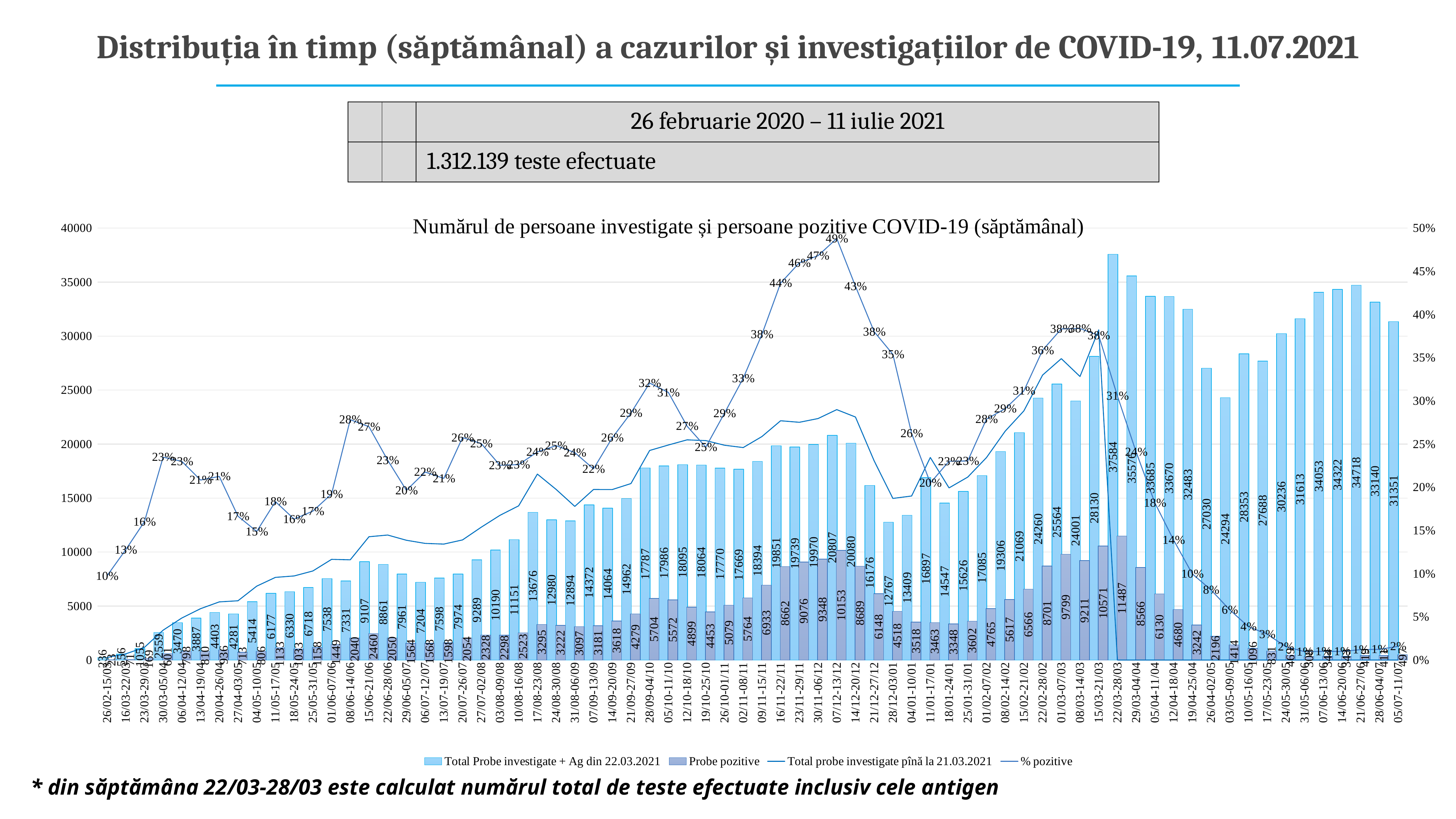
Which week has the highest Probe pozitive value? 22/03-28/03 Which is larger, Total Probe investigate for 21/06-27/06 or for 28/06-04/07? 21/06-27/06 Does the % pozitive line rise or fall from the week 22/03-28/03 to the week 05/07-11/07? Fall What kind of chart is shown on the slide? Combined bar and line chart What is the % pozitive value for the week 07/12-13/12? 49% What is the value of Total Probe investigate for the week 22/03-28/03? 37584 Which week has the highest Total Probe investigate bar? 22/03-28/03 What is the title of the chart? Numărul de persoane investigate și persoane pozitive COVID-19 (săptămânal) What is the value of Probe pozitive for the week 07/12-13/12? 10153 How many series does the chart legend list? 4 What is the value of Total Probe investigate for the week 05/07-11/07? 31351 What is the difference between Total Probe investigate for 22/03-28/03 and for 29/03-04/04? 2008